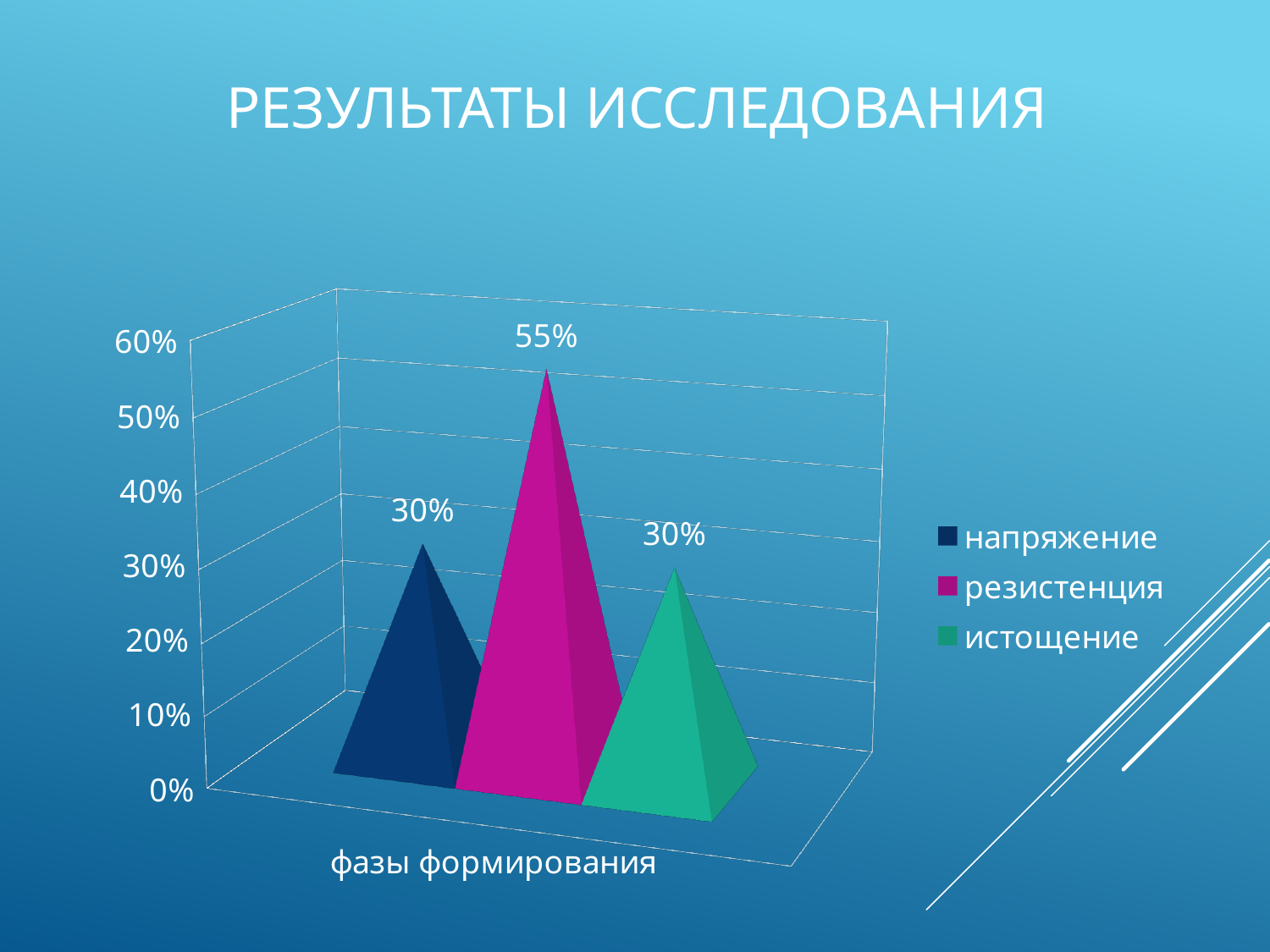
What is the value for напряжение? 30% What is the title of the slide? РЕЗУЛЬТАТЫ ИССЛЕДОВАНИЯ What is the value for резистенция? 55% What is the label on the horizontal axis of the chart? фазы формирования How many series does the legend list? 3 What is the value for истощение? 30% Is the value for резистенция greater or less than 50%? greater Which series has the highest value? резистенция What is the difference between the values for резистенция and напряжение? 25% What kind of chart is shown on the slide? bar chart Which is larger, the value for резистенция or the value for истощение? резистенция Is the value for напряжение greater or less than 40%? less